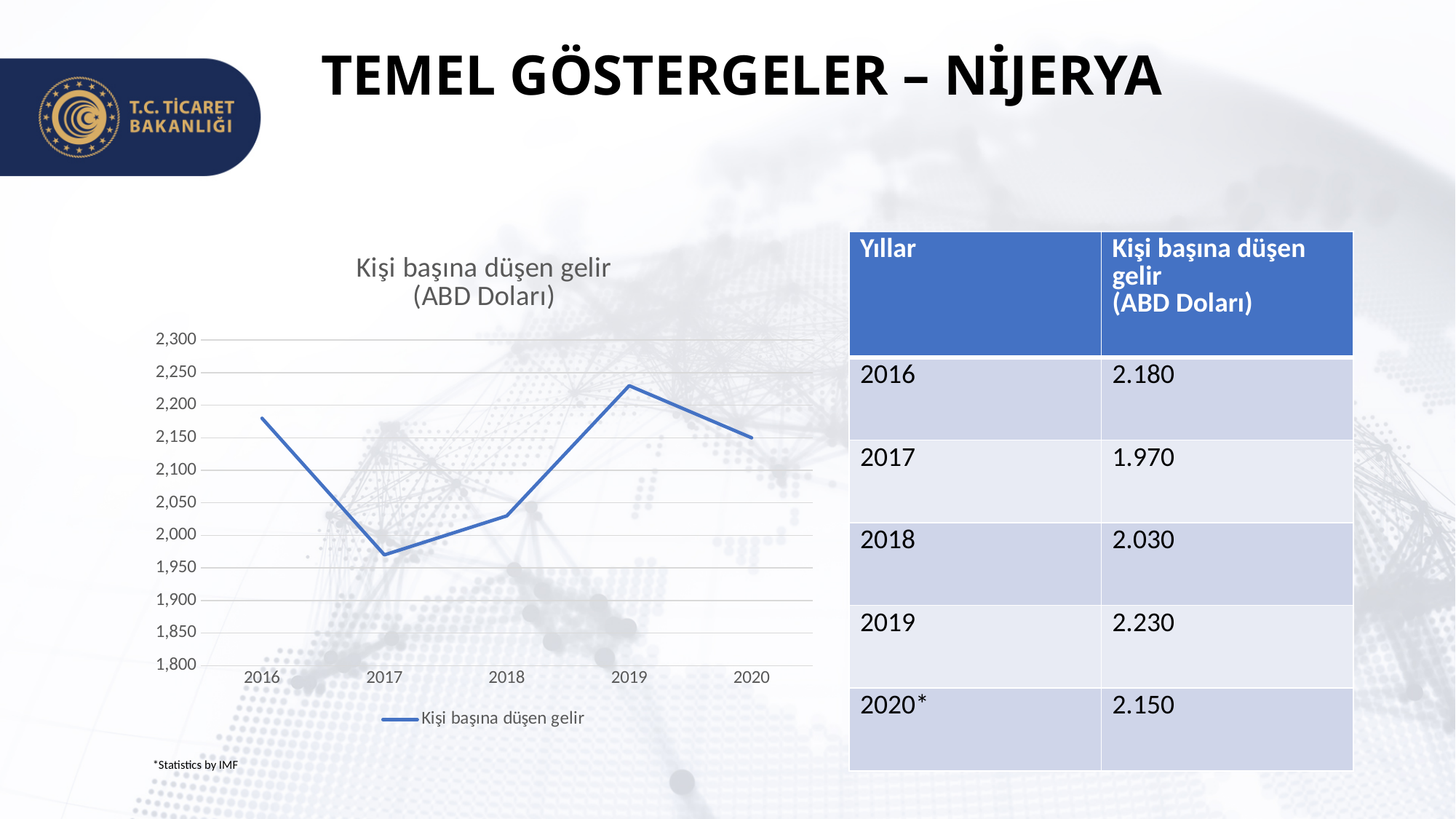
Which year has the lowest per capita income in the chart? 2017 Which year has a larger per capita income, 2016 or 2020? 2016 What is the per capita income value for 2019? 2.230 How many series does the chart legend list? 1 What is the per capita income (Kişi başına düşen gelir) value for 2016? 2.180 What kind of chart is shown on the slide? line chart What is the difference between the per capita income in 2019 and in 2017? 260 How many years are plotted on the x axis of the chart? 5 What is the title of the chart? Kişi başına düşen gelir (ABD Doları) Is the value for 2018 greater or less than 2,050? less Which year has the highest per capita income in the chart? 2019 Does the per capita income rise or fall from 2017 to 2019? rise